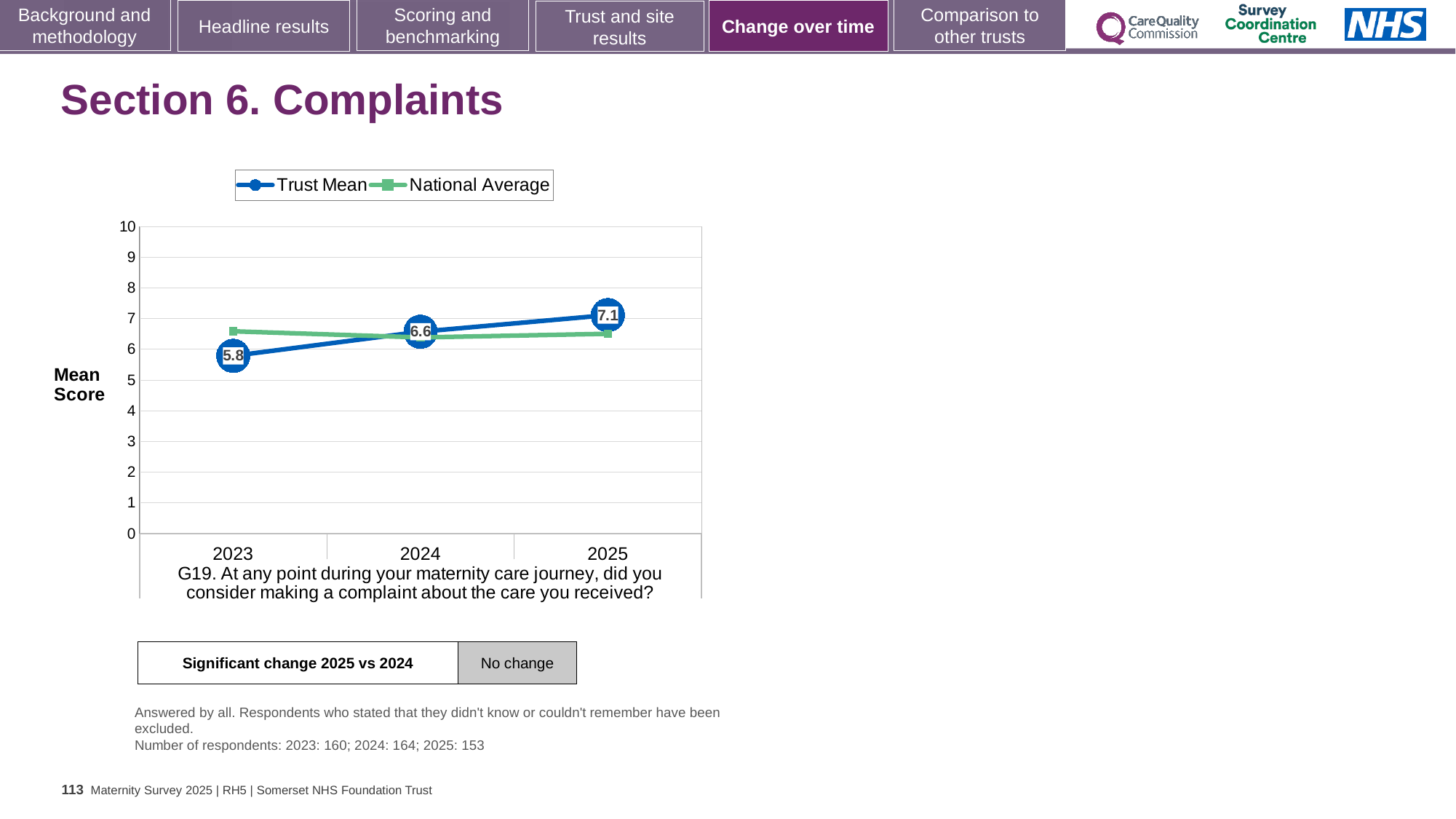
Is the National Average for 2025 greater or less than 7? less In which year is the Trust Mean highest? 2025 How many series does the legend list? 2 What is the Trust Mean score for 2023? 5.8 Which is larger in 2023, the Trust Mean or the National Average? National Average In which year is the Trust Mean lowest? 2023 What kind of chart is shown on the slide? line chart What is the Trust Mean score for 2024? 6.6 What is the difference between the Trust Mean in 2025 and in 2023? 1.3 Does the Trust Mean rise or fall from 2023 to 2025? rise How many years are shown on the x axis? 3 What is the Trust Mean score for 2025? 7.1